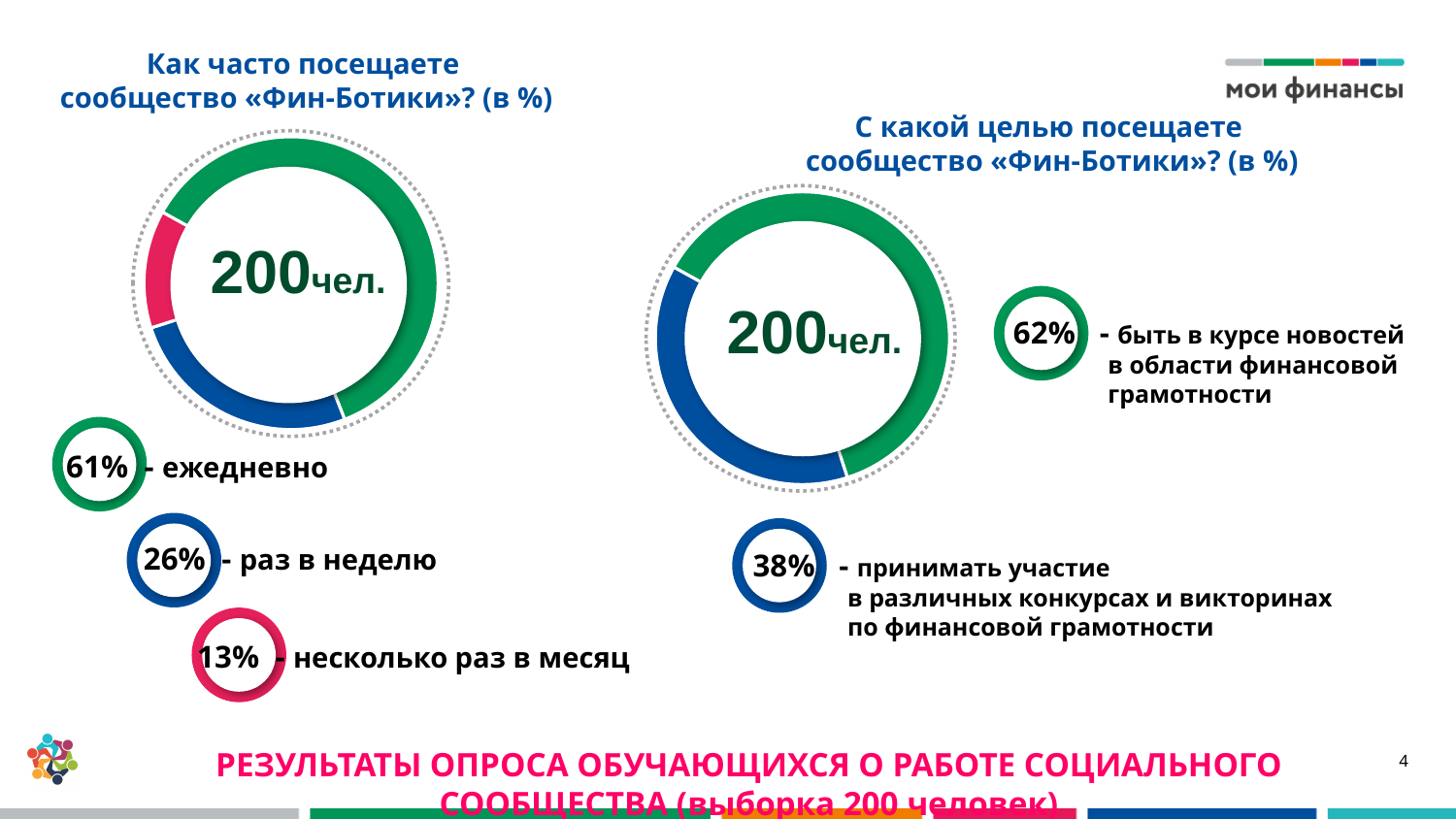
On the left chart ("Как часто посещаете сообщество «Фин-Ботики»?"), what share of respondents visit several times a month (несколько раз в месяц)? 13% On the right chart ("С какой целью посещаете сообщество «Фин-Ботики»?"), what share of respondents visit to take part in contests and quizzes (принимать участие в различных конкурсах и викторинах)? 38% What type of chart is used on the slide for both questions? Donut (pie) chart How many people (чел.) are shown in the centre of each donut chart as the survey sample? 200 On the right chart ("С какой целью посещаете сообщество «Фин-Ботики»?"), what share of respondents visit to keep up with financial literacy news (быть в курсе новостей)? 62% On the left chart ("Как часто посещаете сообщество «Фин-Ботики»?"), how many categories are shown? 3 On the left chart ("Как часто посещаете сообщество «Фин-Ботики»?"), which category has the largest share? ежедневно On the left chart ("Как часто посещаете сообщество «Фин-Ботики»?"), what share of respondents visit once a week (раз в неделю)? 26% On the left chart ("Как часто посещаете сообщество «Фин-Ботики»?"), which category has the smallest share? несколько раз в месяц On the right chart ("С какой целью посещаете сообщество «Фин-Ботики»?"), what is the difference in percentage points between the two categories? 24 On the left chart ("Как часто посещаете сообщество «Фин-Ботики»?"), what is the difference in percentage points between "ежедневно" and "раз в неделю"? 35 On the left chart ("Как часто посещаете сообщество «Фин-Ботики»?"), what share of respondents visit the community daily (ежедневно)? 61%